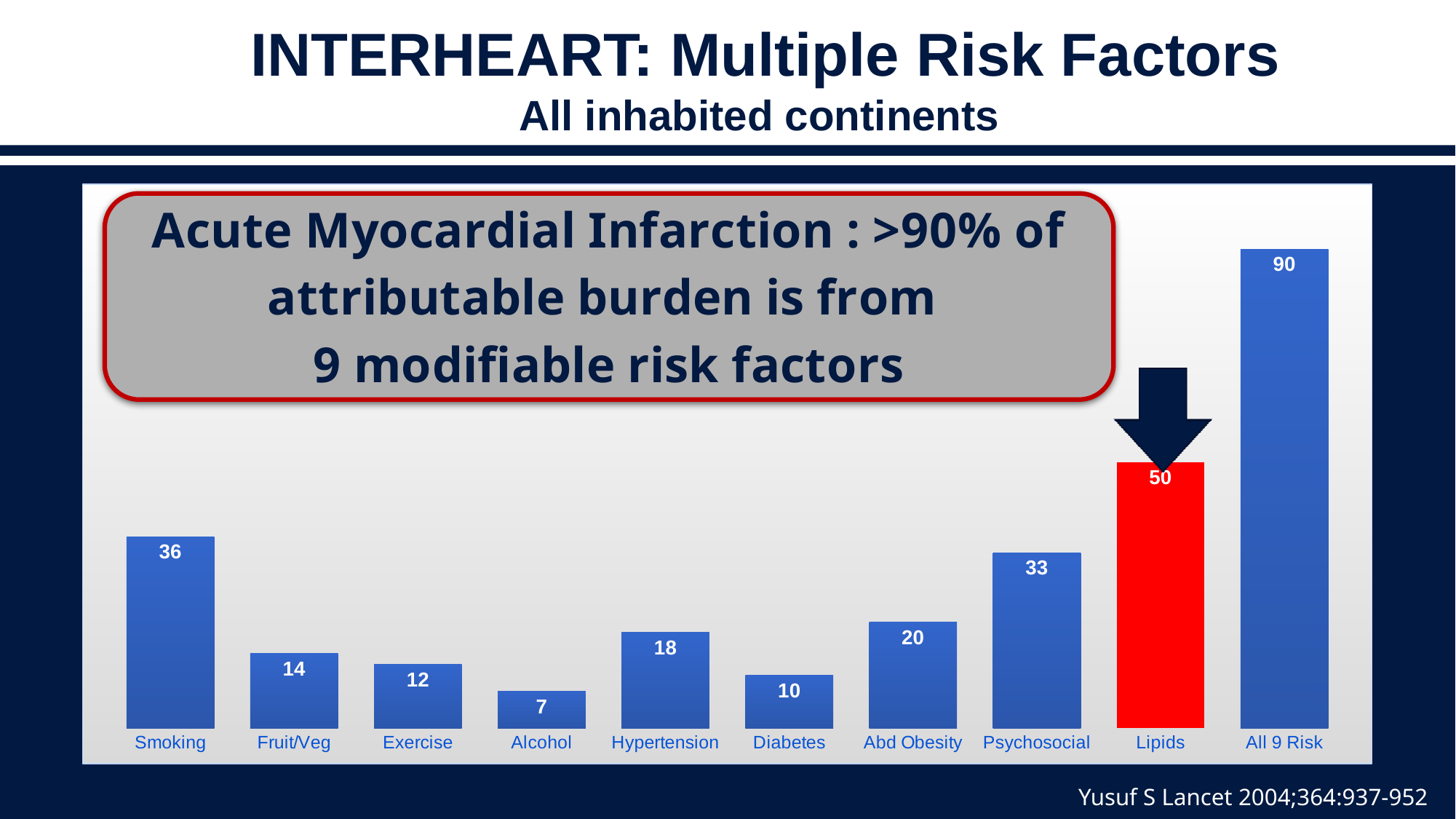
What kind of chart is shown on the slide? Bar chart Which bar is coloured red rather than blue? Lipids Which is larger, the value for Hypertension or the value for Abd Obesity? Abd Obesity What is the value for Lipids? 50 What is the difference between the values for Smoking and Psychosocial? 3 Which category has the lowest value? Alcohol What is the difference between the values for All 9 Risk and Lipids? 40 What is the value for Smoking? 36 What is the value for Alcohol? 7 Which category has the highest value? All 9 Risk How many categories are shown on the chart? 10 What is the value for Psychosocial? 33